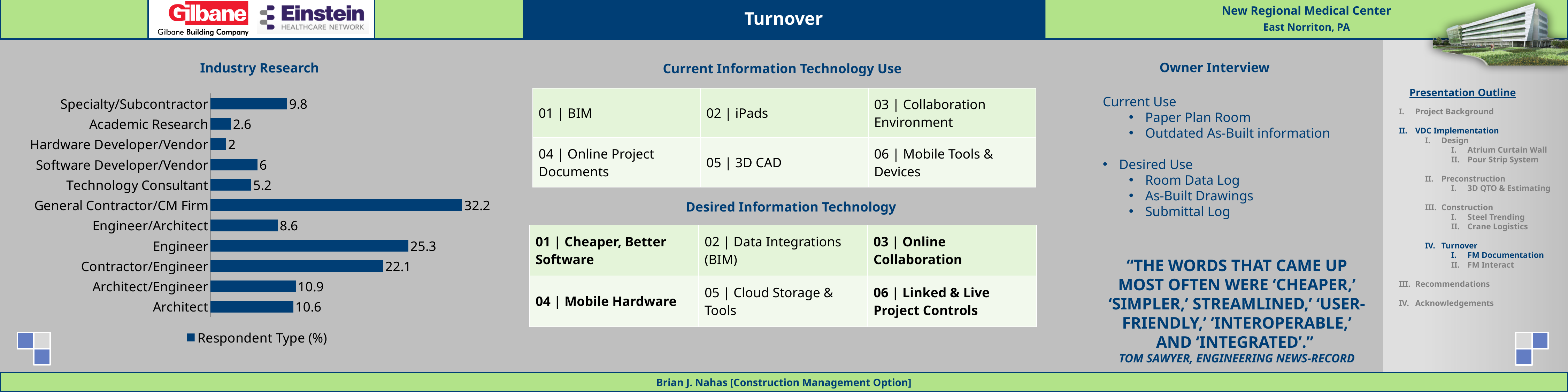
What is the difference between the values for Engineer and Specialty/Subcontractor in the Industry Research chart? 15.5 Which respondent type has the highest value in the Industry Research chart? General Contractor/CM Firm What is the value for Contractor/Engineer in the Industry Research chart? 22.1 What is the difference between the values for Architect/Engineer and Architect in the Industry Research chart? 0.3 What is the value for Academic Research in the Industry Research chart? 2.6 What kind of chart is the Industry Research chart? Bar chart Which respondent type has the lowest value in the Industry Research chart? Hardware Developer/Vendor What is the value for General Contractor/CM Firm in the Industry Research chart? 32.2 How many series does the legend of the Industry Research chart list? 1 What is the legend entry of the Industry Research chart? Respondent Type (%) Which has a larger value in the Industry Research chart, Software Developer/Vendor or Technology Consultant? Software Developer/Vendor How many respondent types are shown in the Industry Research chart? 11